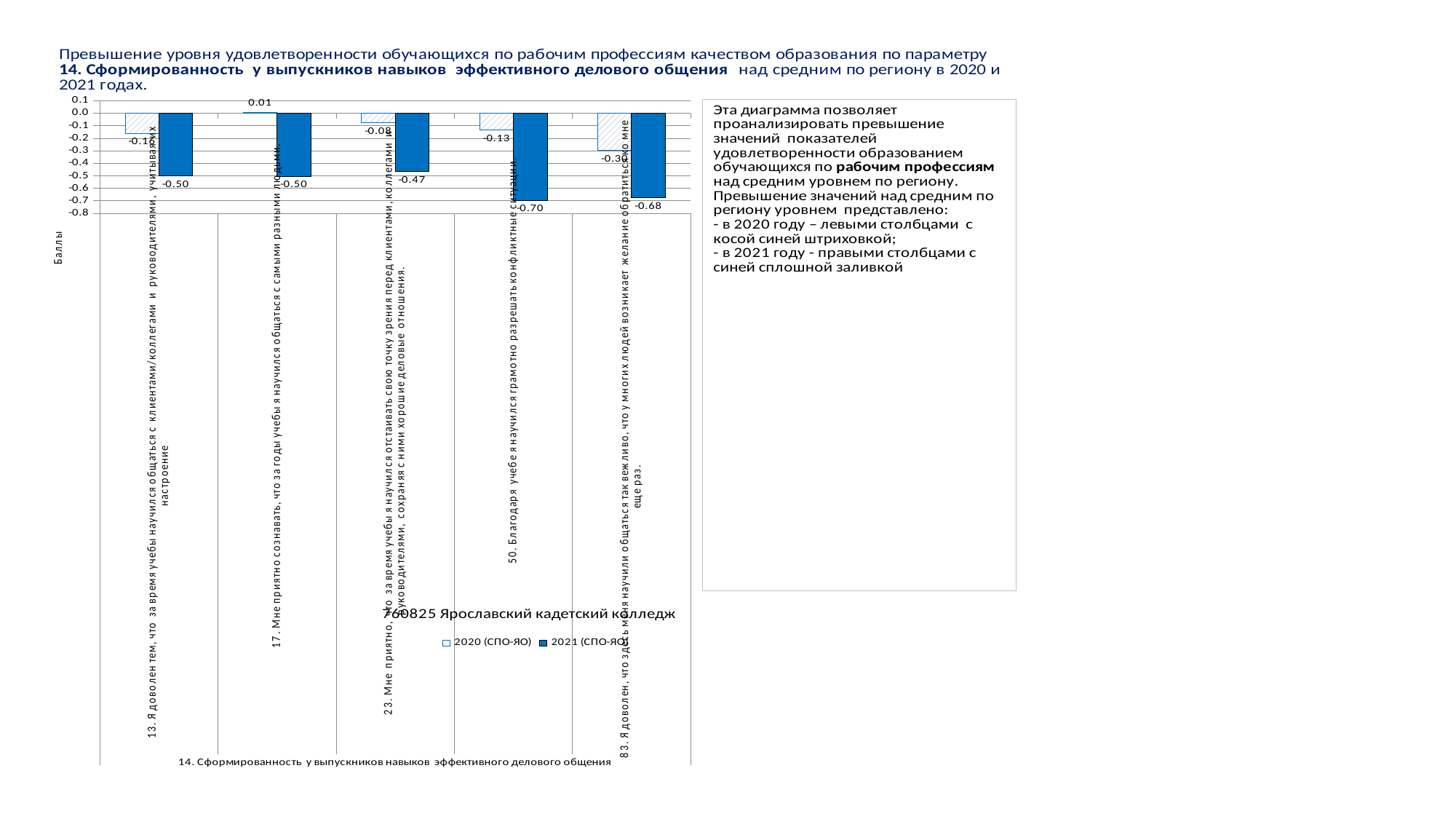
What is the 2021 (СПО-ЯО) value for question 23? -0.47 What is the difference between the 2021 (СПО-ЯО) values for question 50 and question 23? 0.23 What is the 2021 (СПО-ЯО) value for question 50 (Благодаря учебе я научился грамотно разрешать конфликтные ситуации)? -0.70 Which question has the highest 2020 (СПО-ЯО) value? 17 How many categories (questions) are plotted on the x axis of the chart? 5 What is the 2020 (СПО-ЯО) value for question 50? -0.13 What are the two legend entries of the chart? 2020 (СПО-ЯО) and 2021 (СПО-ЯО) What is the 2020 (СПО-ЯО) value for question 23? -0.08 What is the 2020 (СПО-ЯО) value for question 17 (Мне приятно сознавать, что за годы учебы я научился общаться с самыми разными людьми)? 0.01 What type of chart is shown on the slide? bar chart Which question has the lowest 2021 (СПО-ЯО) value? 50 How many series does the chart legend list? 2